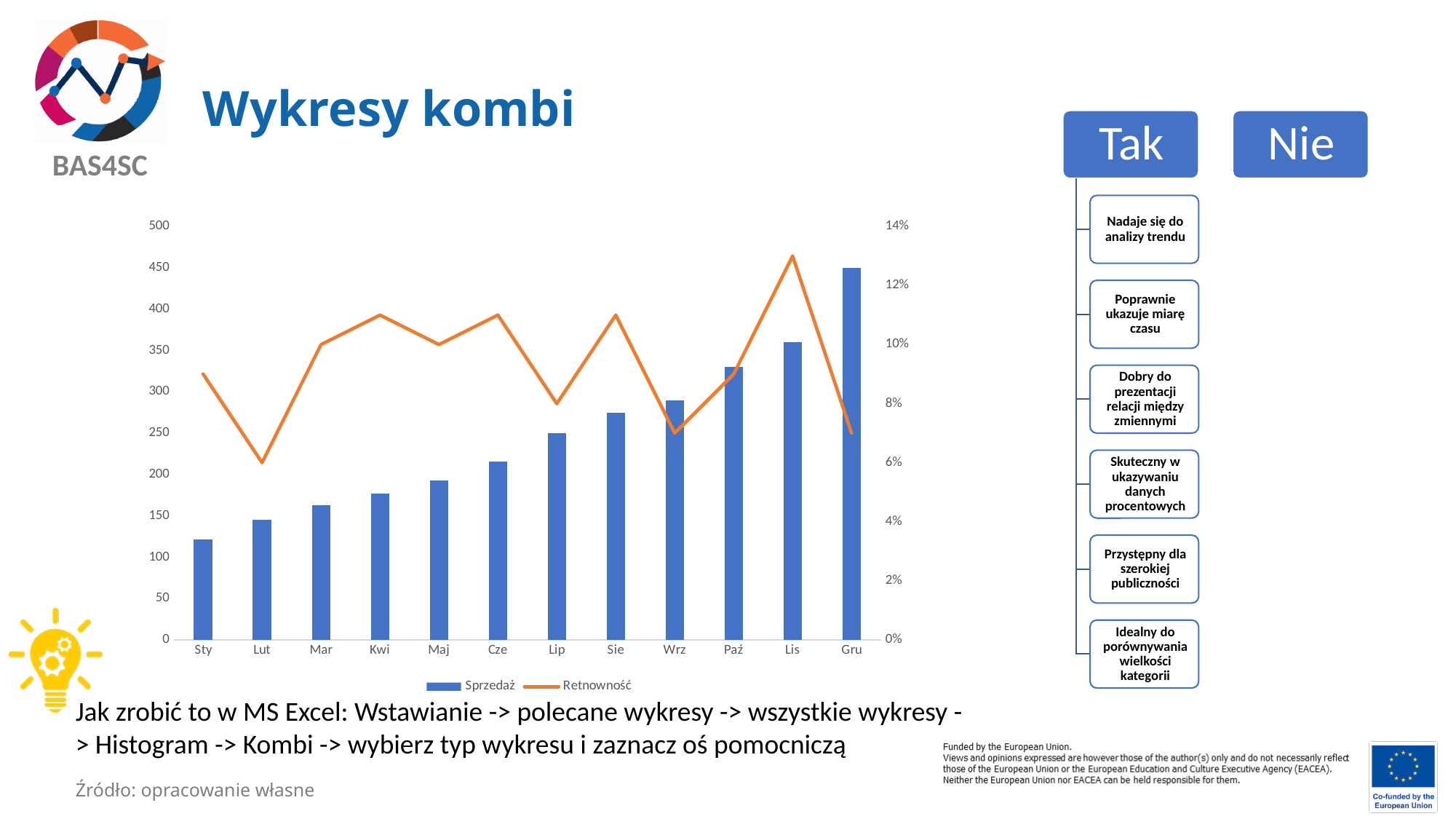
How many months (categories) are shown on the x axis? 12 Is the Sprzedaż value for Gru greater or less than 400? greater Do the Sprzedaż bars generally rise or fall from Sty to Gru? Rise What are the two series named in the legend? Sprzedaż and Retnowność Which month has the lowest Sprzedaż bar? Sty In which month does the Retnowność line reach its highest point? Lis How many series does the chart legend list? 2 Which month has the highest Sprzedaż bar? Gru Is the Retnowność value for Lis greater or less than 12%? greater In which month does the Retnowność line reach its lowest point? Lut Which month has the larger Sprzedaż bar, Paź or Wrz? Paź What kind of chart is shown on the slide? A combination chart with bars and a line